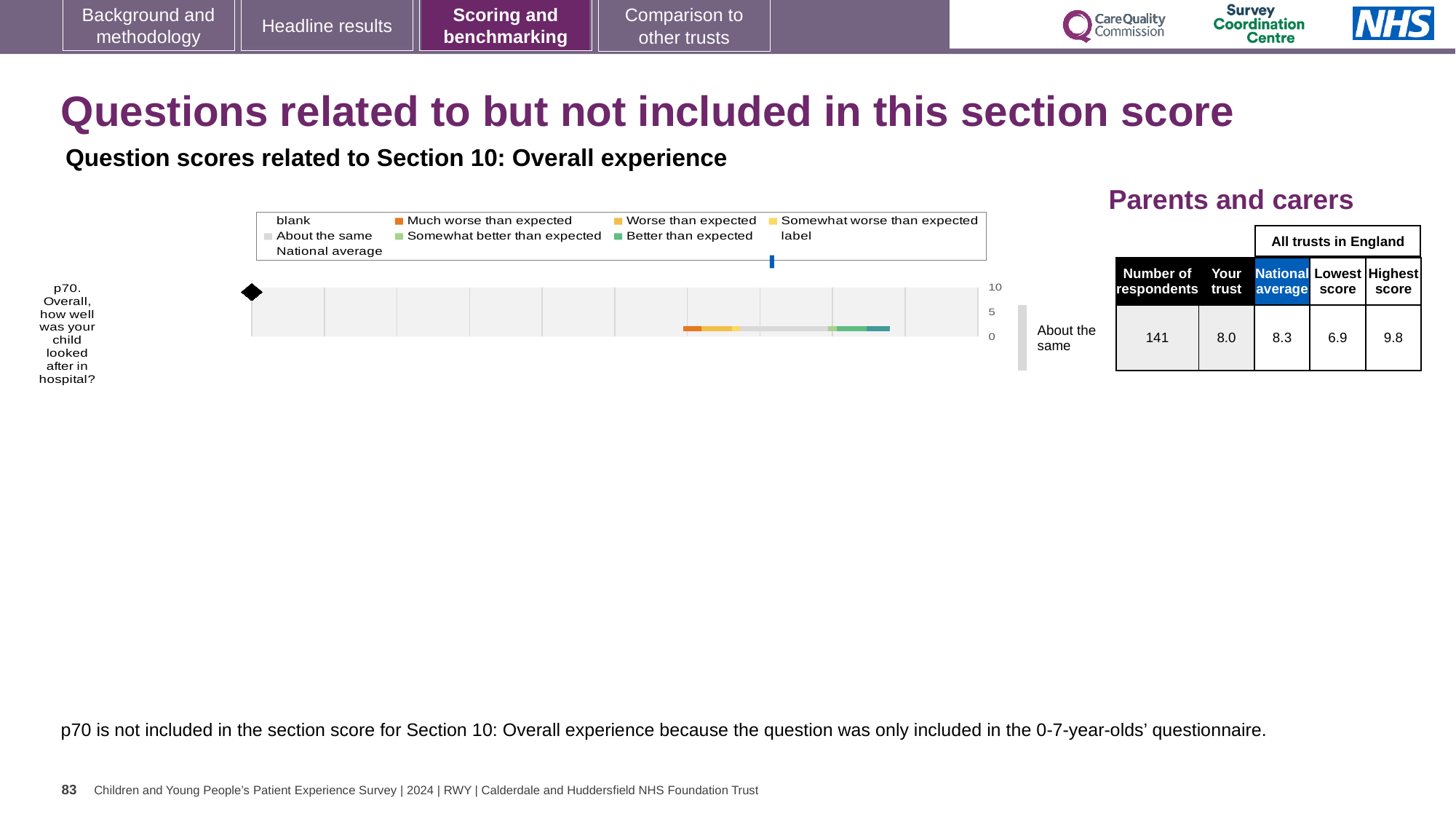
What is the number of respondents for p70 shown in the table beside the chart? 141 Which question is plotted in the chart? p70. Overall, how well was your child looked after in hospital? What is the lowest score across all trusts in England for p70? 6.9 For p70, which is larger: the 'Your trust' score or the national average? National average What benchmark category label is shown to the right of the p70 bar? About the same For p70, what is the difference between the highest score and the lowest score across all trusts in England? 2.9 What is the national average score for p70 in the table beside the chart? 8.3 How many questions (categories) are plotted in the chart? 1 How many entries does the chart legend list? 9 What kind of chart is used to show the p70 question score? bar chart What is the highest score across all trusts in England for p70? 9.8 What is the 'Your trust' score for p70 in the table beside the chart? 8.0